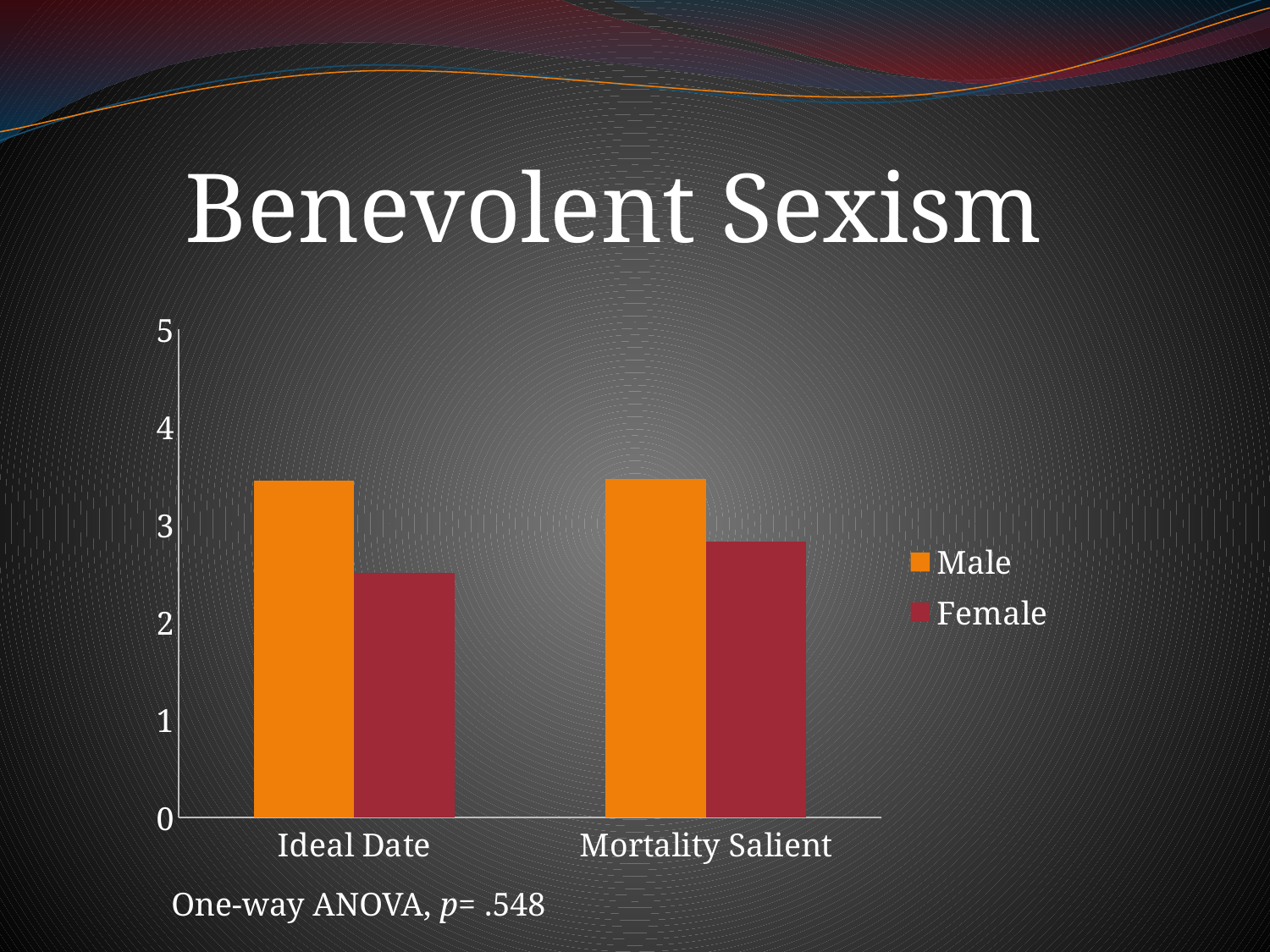
Is the Female value for Ideal Date greater or less than 3? less How many series does the chart's legend list? 2 For Mortality Salient, which is larger, the Male value or the Female value? Male What is the title of the slide containing the chart? Benevolent Sexism What kind of chart is shown on the slide? bar chart Is the Female value for Mortality Salient greater or less than 2? greater Which series is shown in orange in the chart? Male Which bar in the chart is the lowest? Female, Ideal Date For Ideal Date, which is larger, the Male value or the Female value? Male Is the Male value for Mortality Salient greater or less than 3? greater How many categories are shown on the x axis of the chart? 2